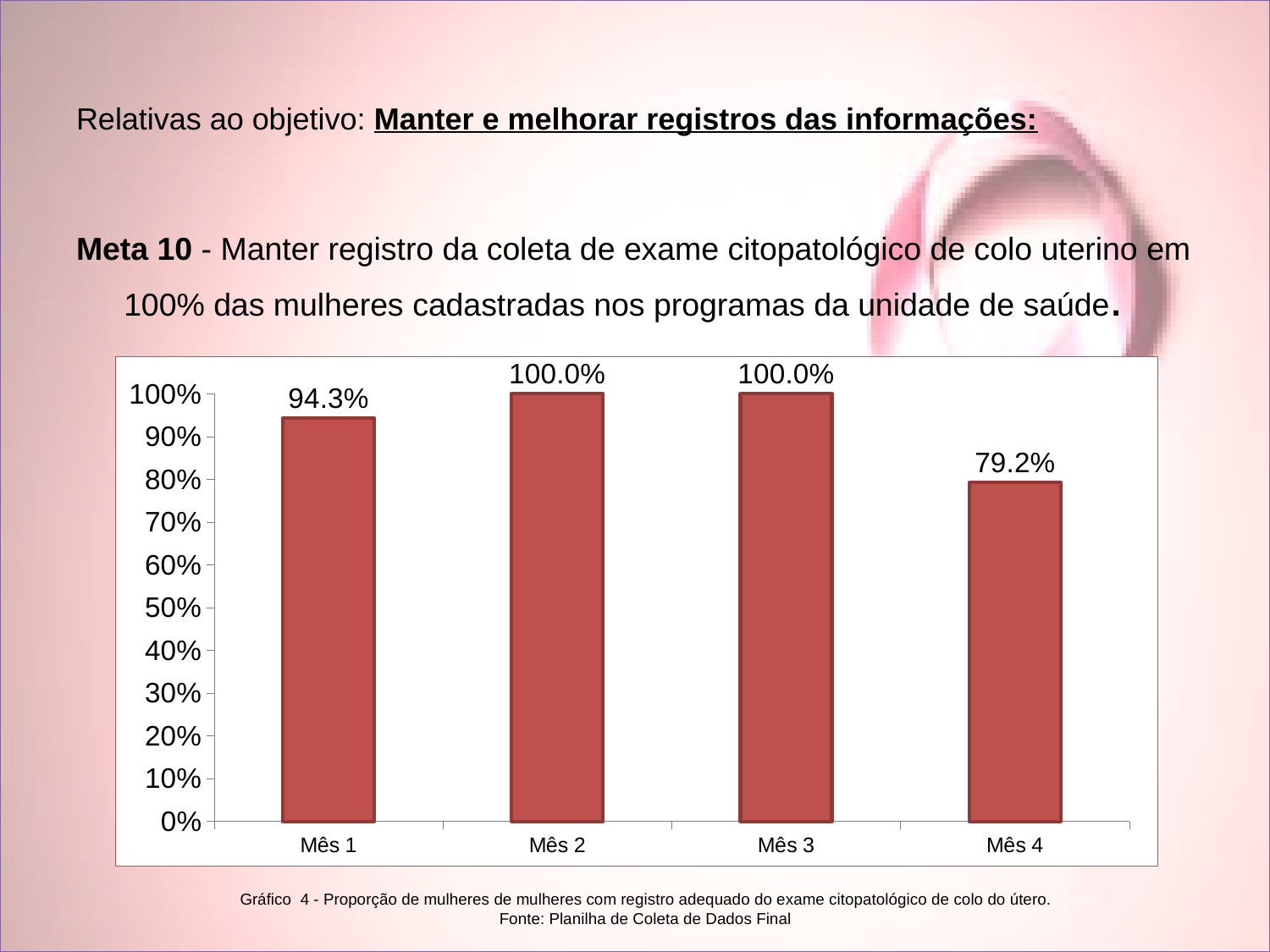
Is the value for Mês 4 greater or less than 80%? less What is the difference between the values for Mês 1 and Mês 4? 15.1% What is the value for Mês 4? 79.2% How many months are shown on the x axis? 4 What is the value for Mês 1? 94.3% Which months reached 100.0%? Mês 2 and Mês 3 What kind of chart is shown on the slide? bar chart What is the value for Mês 2? 100.0% Is the value for Mês 1 greater or less than 90%? greater Which month has the lowest value? Mês 4 Which is larger, the value for Mês 1 or the value for Mês 4? Mês 1 What is the difference between the values for Mês 2 and Mês 1? 5.7%